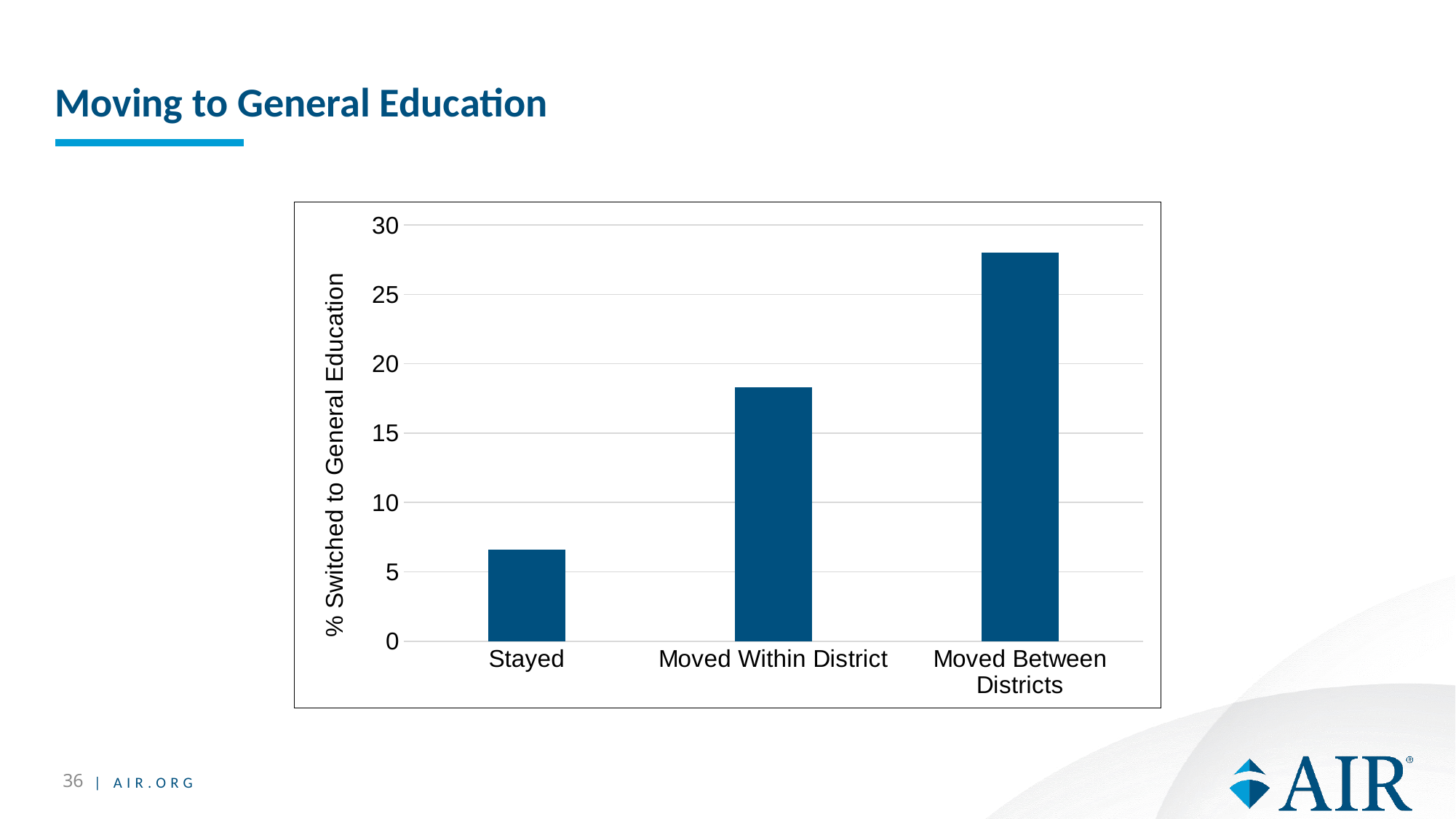
Which category has the highest percentage switched to general education? Moved Between Districts How many categories are shown on the x axis? 3 Is the value for Moved Within District greater or less than 20? less Is the value for Moved Between Districts greater or less than 25? greater Is the value for Moved Within District greater or less than 15? greater What kind of chart is shown on the slide? bar chart Which is larger, the value for Stayed or the value for Moved Within District? Moved Within District What is the title of the slide containing the chart? Moving to General Education Do the values rise or fall from left to right along the x axis? rise Which category has the lowest percentage switched to general education? Stayed What is the label of the vertical axis? % Switched to General Education